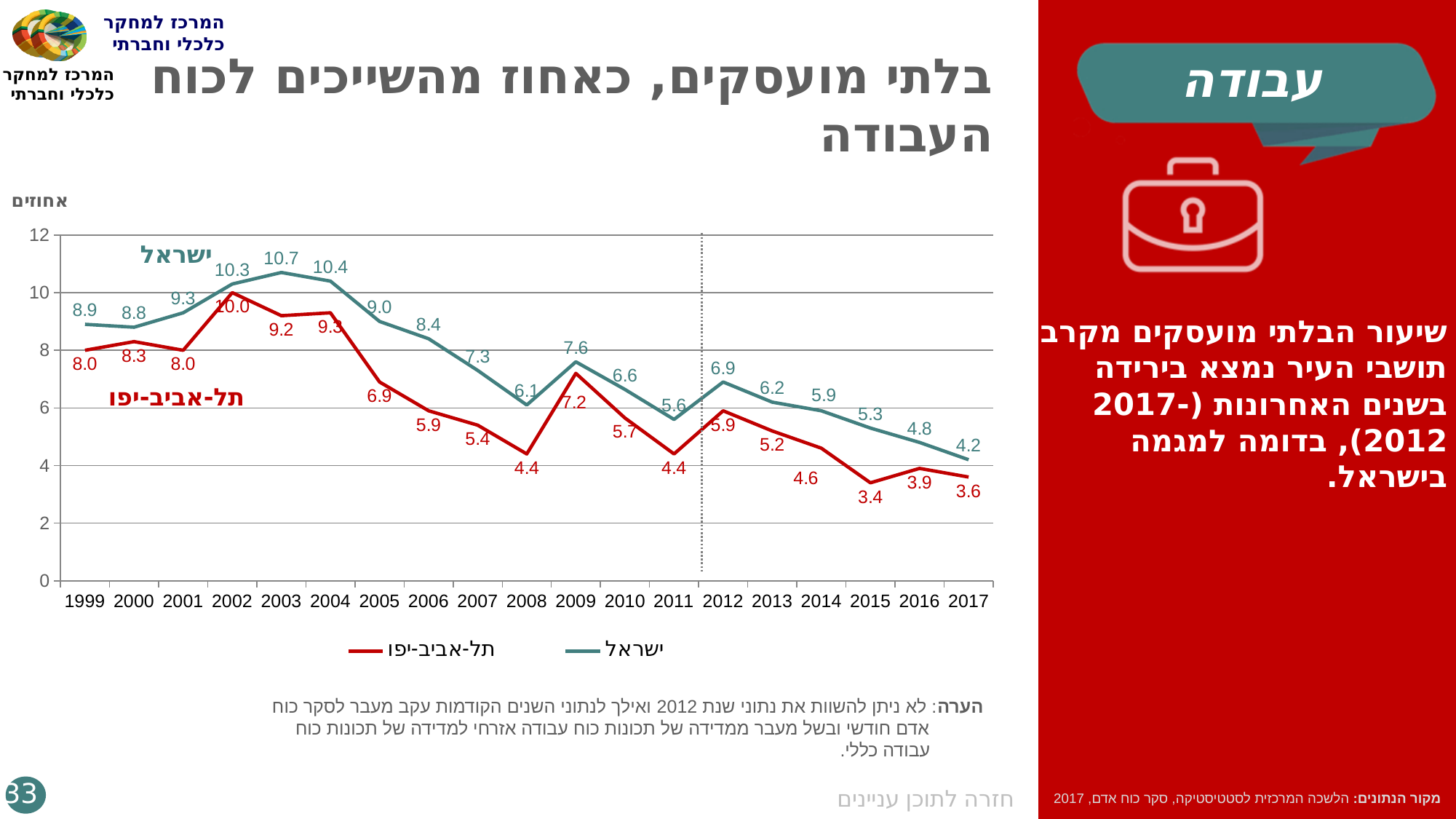
What is the difference between the ישראל and תל-אביב-יפו values in 2017? 0.6 In which year is the תל-אביב-יפו series at its lowest? 2015 What is the value for תל-אביב-יפו in 2009? 7.2 How many years are shown on the x axis? 19 What colour is the line for תל-אביב-יפו? red In which year is the ישראל series at its highest? 2003 Does the ישראל series generally rise or fall from 2004 to 2017? fall What kind of chart is shown on the slide? line chart What is the value for תל-אביב-יפו in 2017? 3.6 How many series does the legend list? 2 Which series has the higher value in 2008, ישראל or תל-אביב-יפו? ישראל What is the value for ישראל in 2003? 10.7